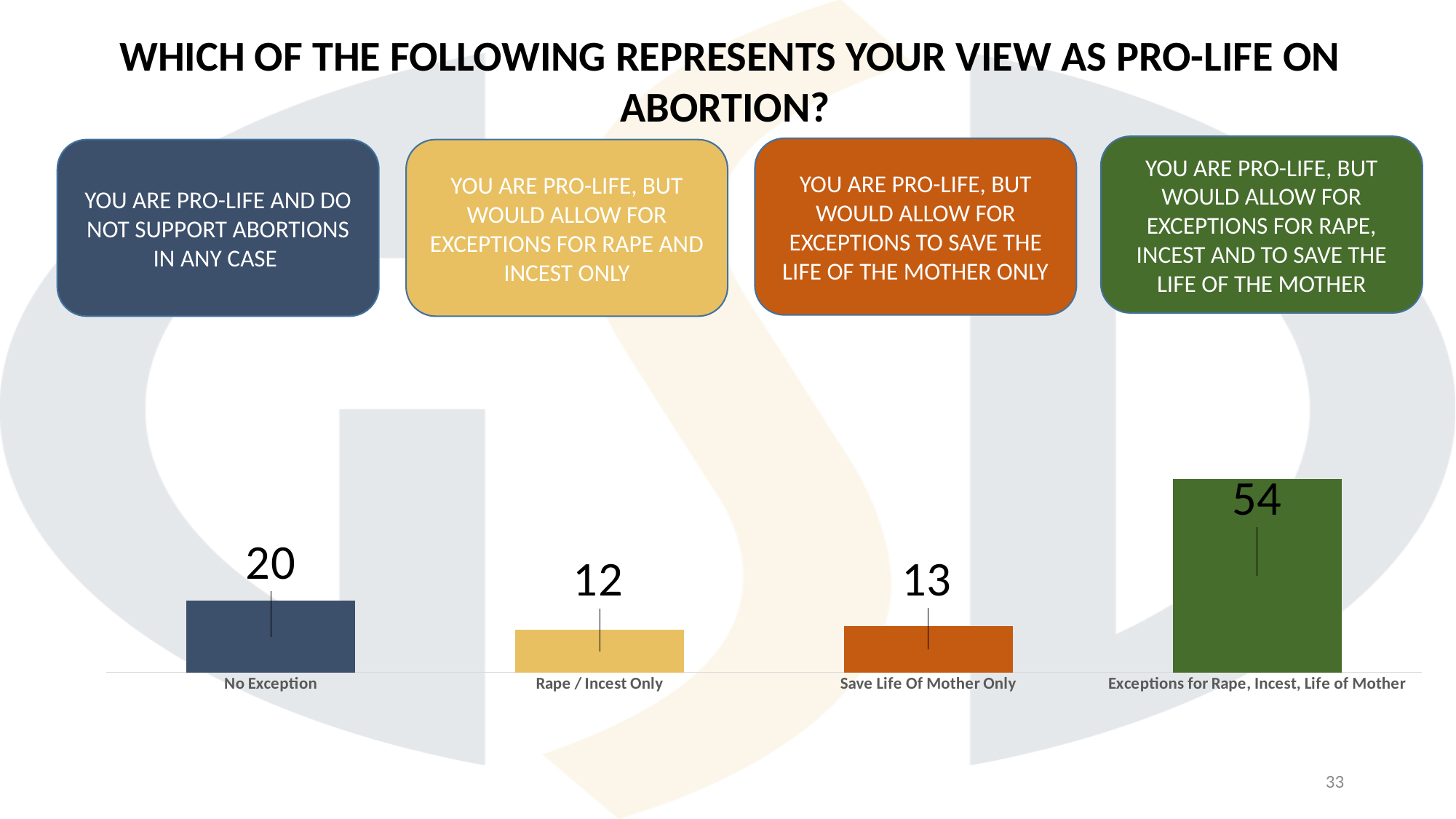
What is the value for No Exception? 20 What is the value for Exceptions for Rape, Incest, Life of Mother? 54 What is the difference between the values for Exceptions for Rape, Incest, Life of Mother and No Exception? 34 Which category has the lowest value? Rape / Incest Only What colour is the bar for Exceptions for Rape, Incest, Life of Mother? Green Which is larger, the value for No Exception or the value for Save Life Of Mother Only? No Exception What is the value for Save Life Of Mother Only? 13 How many categories are shown in the chart? 4 Which category has the highest value? Exceptions for Rape, Incest, Life of Mother What is the value for Rape / Incest Only? 12 What kind of chart is shown on the slide? Bar chart What is the difference between the values for No Exception and Rape / Incest Only? 8